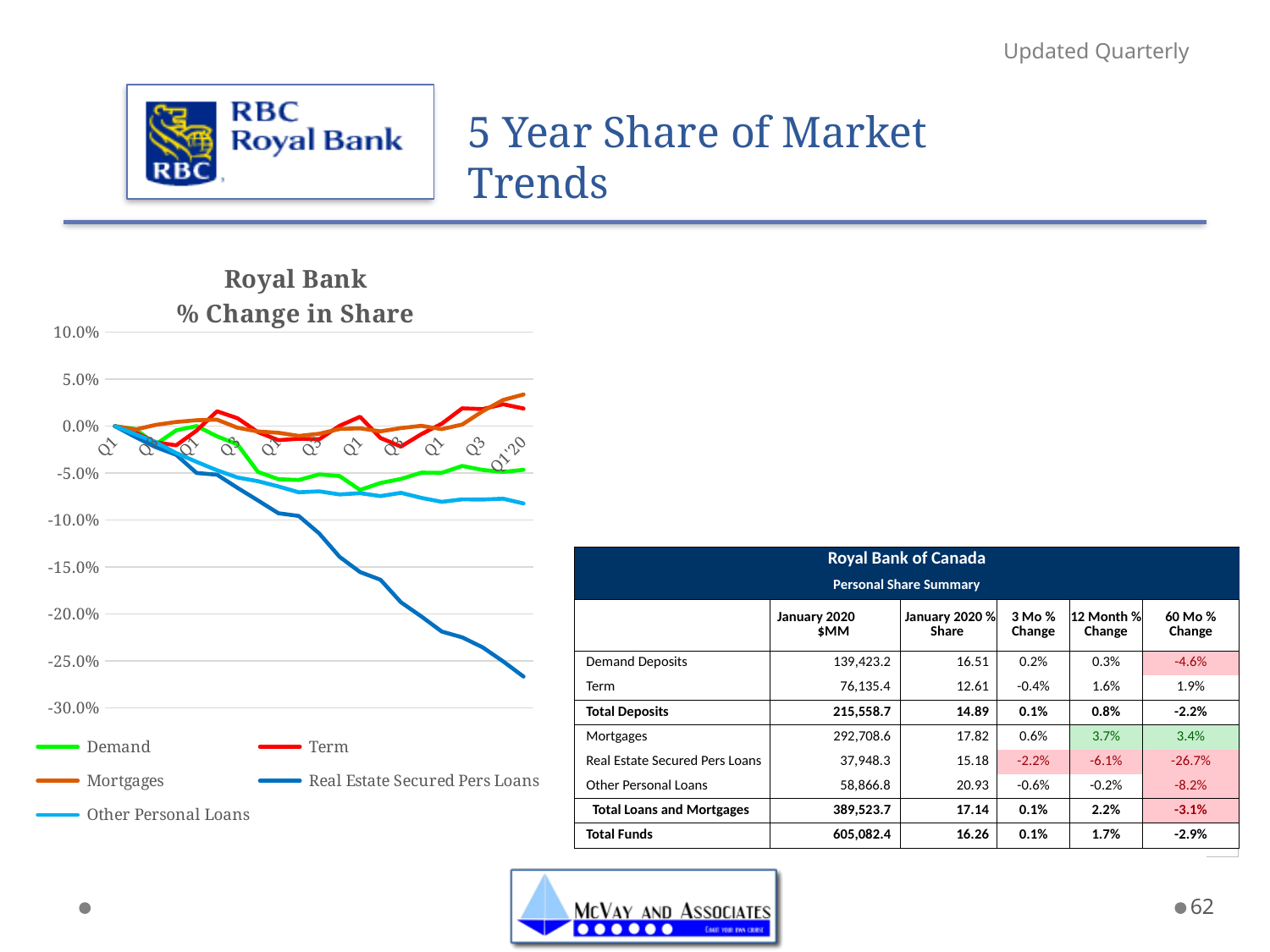
What kind of chart is shown on the slide? line chart Which series has the highest value at the end of the chart (Q1'20)? Mortgages At Q1'20, which is higher: Demand or Other Personal Loans? Demand What is the title of the chart? Royal Bank % Change in Share Is the value for Mortgages at Q1'20 greater or less than 0.0%? greater Does the Real Estate Secured Pers Loans line rise or fall over the period shown? fall Is the value for Real Estate Secured Pers Loans at Q1'20 greater or less than -25.0%? less At Q1'20, which is higher: Mortgages or Term? Mortgages Which series has the lowest value at the end of the chart (Q1'20)? Real Estate Secured Pers Loans How many series does the legend of the chart list? 5 Is the value for Other Personal Loans at Q1'20 greater or less than -5.0%? less Which series are listed in the chart's legend? Demand, Term, Mortgages, Real Estate Secured Pers Loans, Other Personal Loans